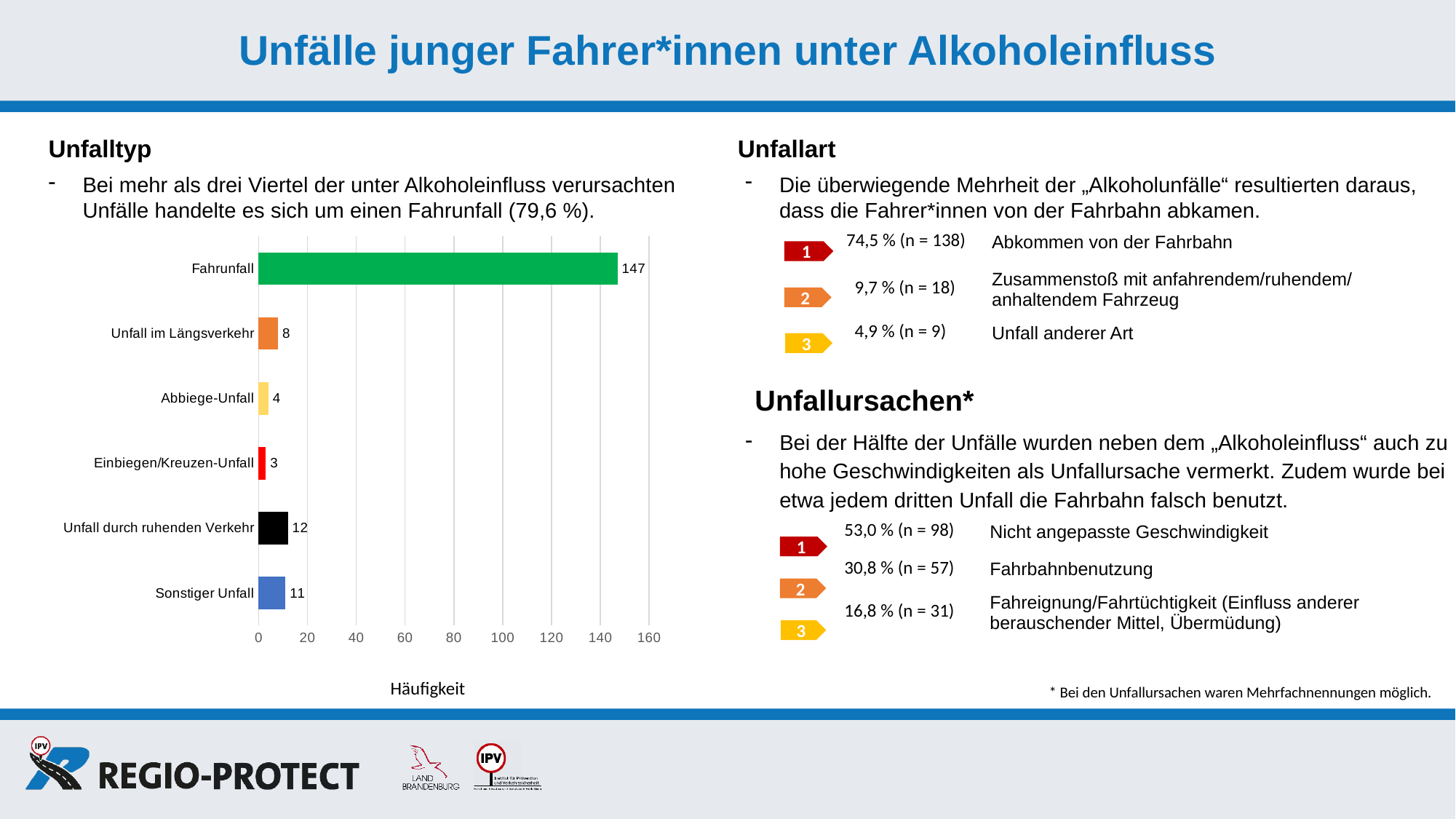
What is the value for Sonstiger Unfall in the bar chart? 11 How many categories are shown in the bar chart? 6 What is the value for Unfall durch ruhenden Verkehr in the bar chart? 12 Which category has the lowest value in the bar chart? Einbiegen/Kreuzen-Unfall Which category has the highest value in the bar chart? Fahrunfall What is the label of the horizontal axis of the bar chart? Häufigkeit What is the difference between the values for Fahrunfall and Unfall durch ruhenden Verkehr? 135 What is the value for Unfall im Längsverkehr in the bar chart? 8 What type of chart is shown under the heading "Unfalltyp"? bar chart What is the value for Fahrunfall in the bar chart? 147 Which is larger in the bar chart: Abbiege-Unfall or Unfall im Längsverkehr? Unfall im Längsverkehr Is the value for Fahrunfall greater or less than 140? greater